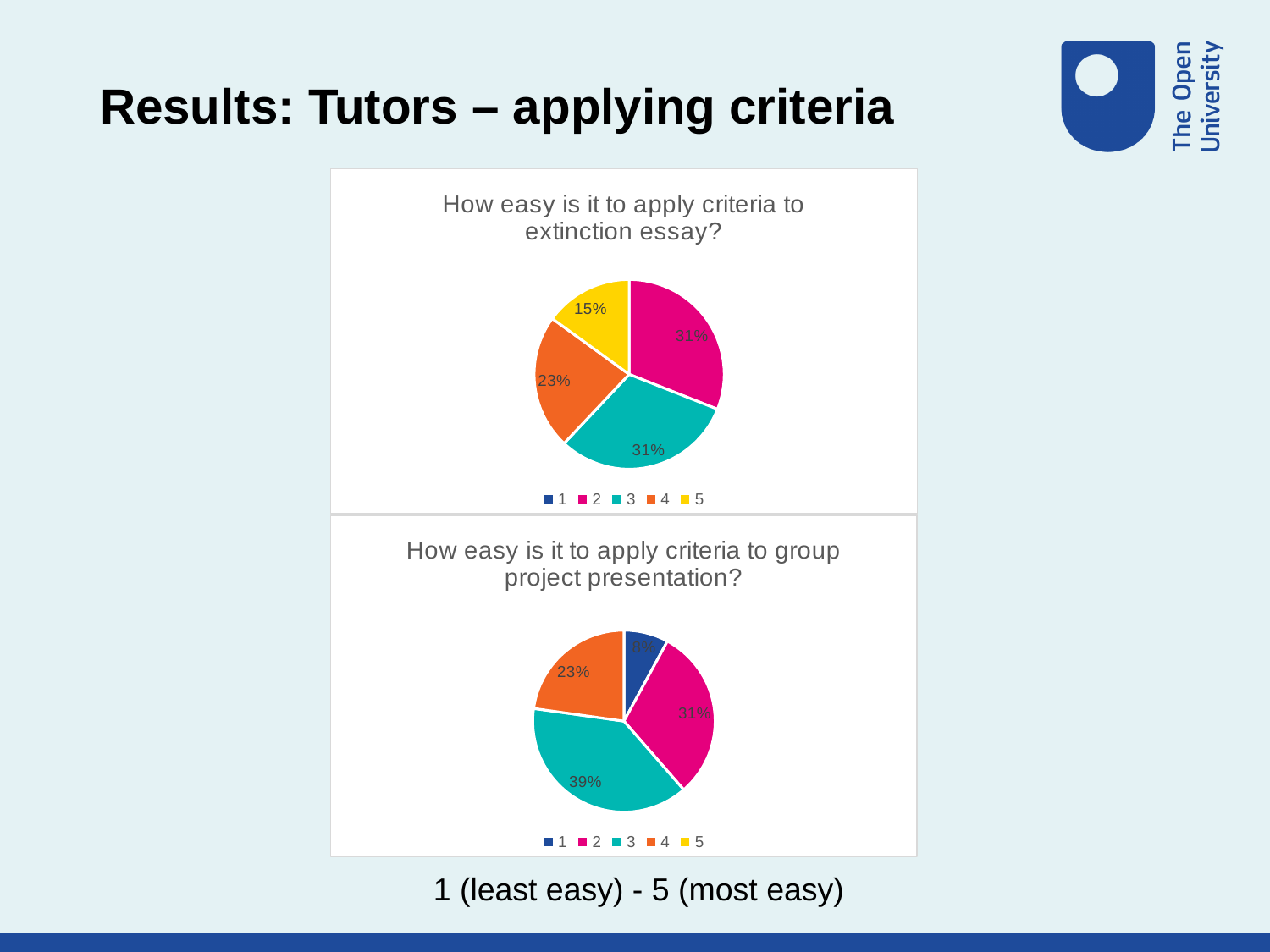
In the chart titled "How easy is it to apply criteria to group project presentation?", which is larger, the slice for rating 2 or the slice for rating 4? 2 In the chart titled "How easy is it to apply criteria to group project presentation?", what share of responses is rating 3? 39% In the chart titled "How easy is it to apply criteria to extinction essay?", what is the difference in percentage points between the slices for rating 4 and rating 5? 8 In the chart titled "How easy is it to apply criteria to group project presentation?", what is the difference in percentage points between the slices for rating 3 and rating 2? 8 What type of chart is used in the chart titled "How easy is it to apply criteria to extinction essay?"? Pie chart In the chart titled "How easy is it to apply criteria to group project presentation?", which rating has the largest slice? 3 In the chart titled "How easy is it to apply criteria to extinction essay?", what share of responses is rating 5? 15% In the chart titled "How easy is it to apply criteria to group project presentation?", which rating has the smallest slice? 1 In the chart titled "How easy is it to apply criteria to group project presentation?", what share of responses is rating 1? 8% How many entries does the legend list in the chart titled "How easy is it to apply criteria to group project presentation?"? 5 In the chart titled "How easy is it to apply criteria to extinction essay?", what share of responses is rating 4? 23% In the chart titled "How easy is it to apply criteria to extinction essay?", which rating has the smallest slice? 5